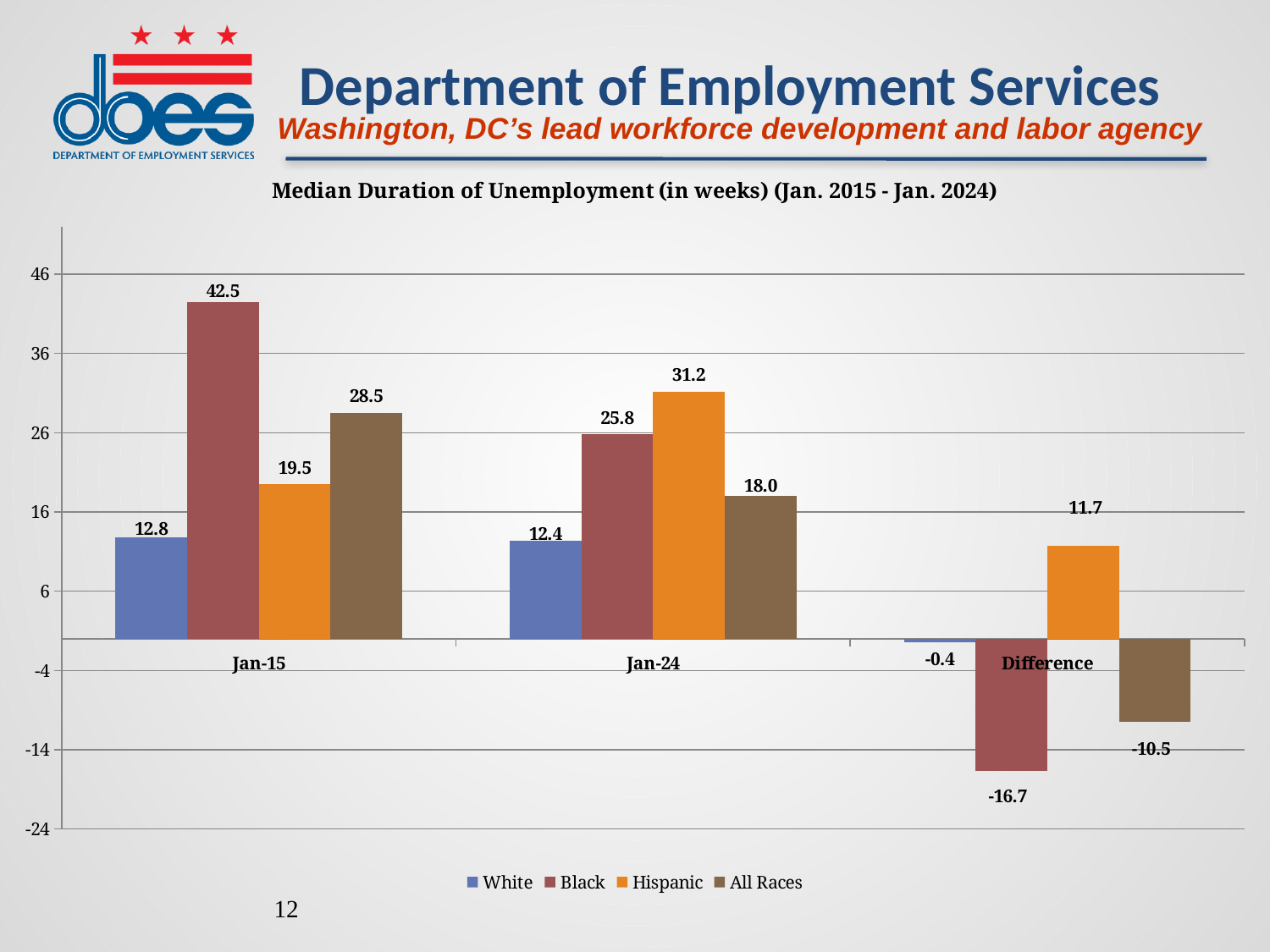
Which is larger in Jan-24, the value for Hispanic or the value for All Races? Hispanic Which series has the lowest value in Jan-24? White Is the value for All Races in Jan-15 greater or less than 26? greater What kind of chart is shown on the slide? Bar chart How many categories are shown on the x axis? 3 What is the Difference value for All Races? -10.5 What is the median duration of unemployment for Black workers in Jan-15? 42.5 What is the title of the chart? Median Duration of Unemployment (in weeks) (Jan. 2015 - Jan. 2024) Which series has the highest value in Jan-15? Black What is the value for Hispanic workers in Jan-24? 31.2 What is the difference between the Black value in Jan-15 and the Black value in Jan-24? 16.7 How many series does the legend list? 4